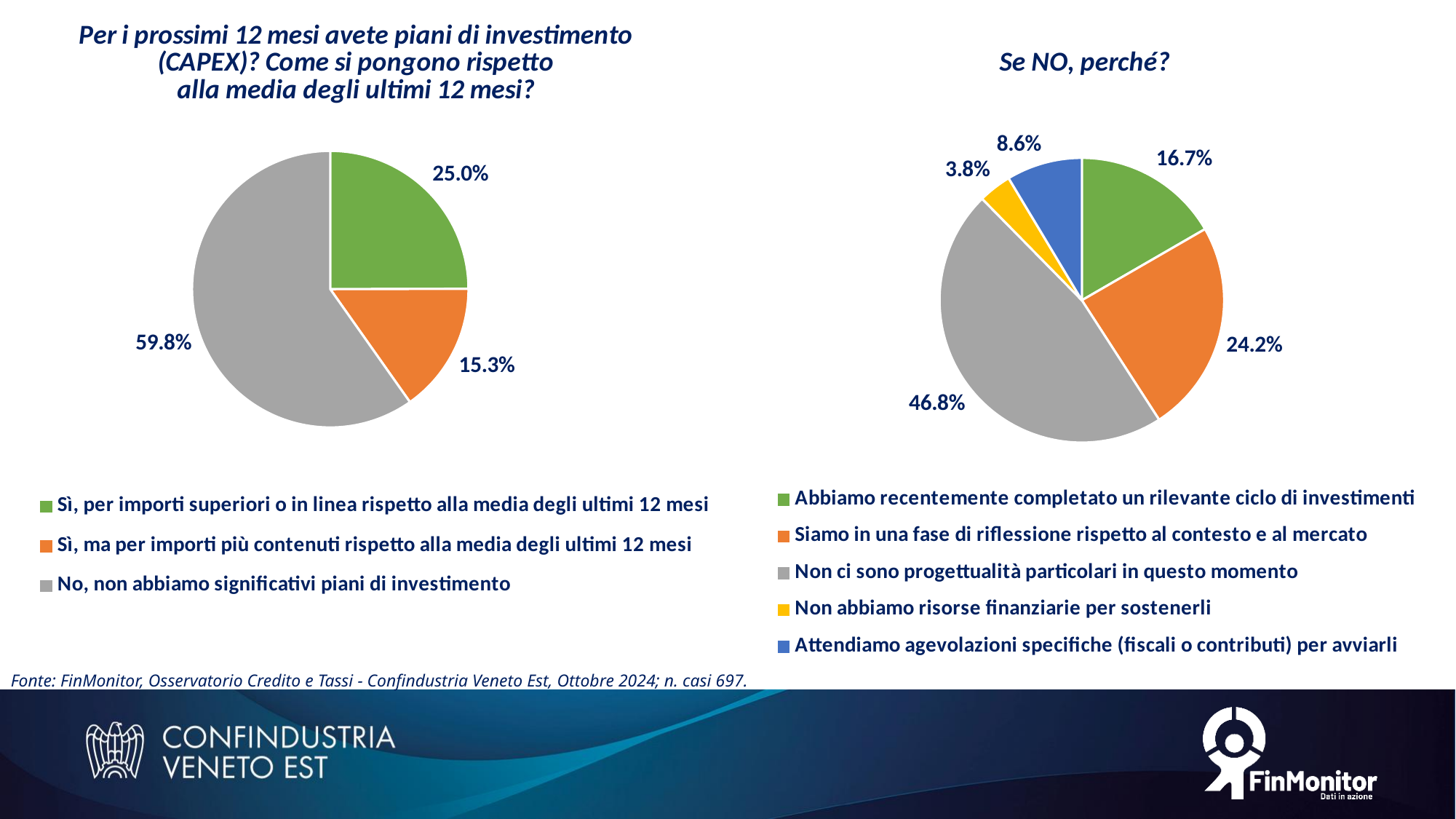
In the left pie chart, which category has the largest share? No, non abbiamo significativi piani di investimento In the left pie chart (Per i prossimi 12 mesi avete piani di investimento), what share is 'No, non abbiamo significativi piani di investimento'? 59.8% How many categories does the left pie chart show? 3 In the right pie chart (Se NO, perché?), what share is 'Siamo in una fase di riflessione rispetto al contesto e al mercato'? 24.2% How many categories does the right pie chart (Se NO, perché?) show? 5 In the left pie chart, what is the difference between the 'Sì, per importi superiori o in linea' share and the 'Sì, ma per importi più contenuti' share? 9.7% In the right pie chart, which is larger: 'Abbiamo recentemente completato un rilevante ciclo di investimenti' or 'Siamo in una fase di riflessione rispetto al contesto e al mercato'? Siamo in una fase di riflessione rispetto al contesto e al mercato What type of chart is used on the right side of the slide (Se NO, perché?)? Pie chart In the left pie chart, what share is 'Sì, ma per importi più contenuti rispetto alla media degli ultimi 12 mesi'? 15.3% In the right pie chart, what share is 'Attendiamo agevolazioni specifiche (fiscali o contributi) per avviarli'? 8.6% In the right pie chart, what is the difference between 'Non ci sono progettualità particolari in questo momento' and 'Siamo in una fase di riflessione rispetto al contesto e al mercato'? 22.6% In the right pie chart, which category has the smallest share? Non abbiamo risorse finanziarie per sostenerli